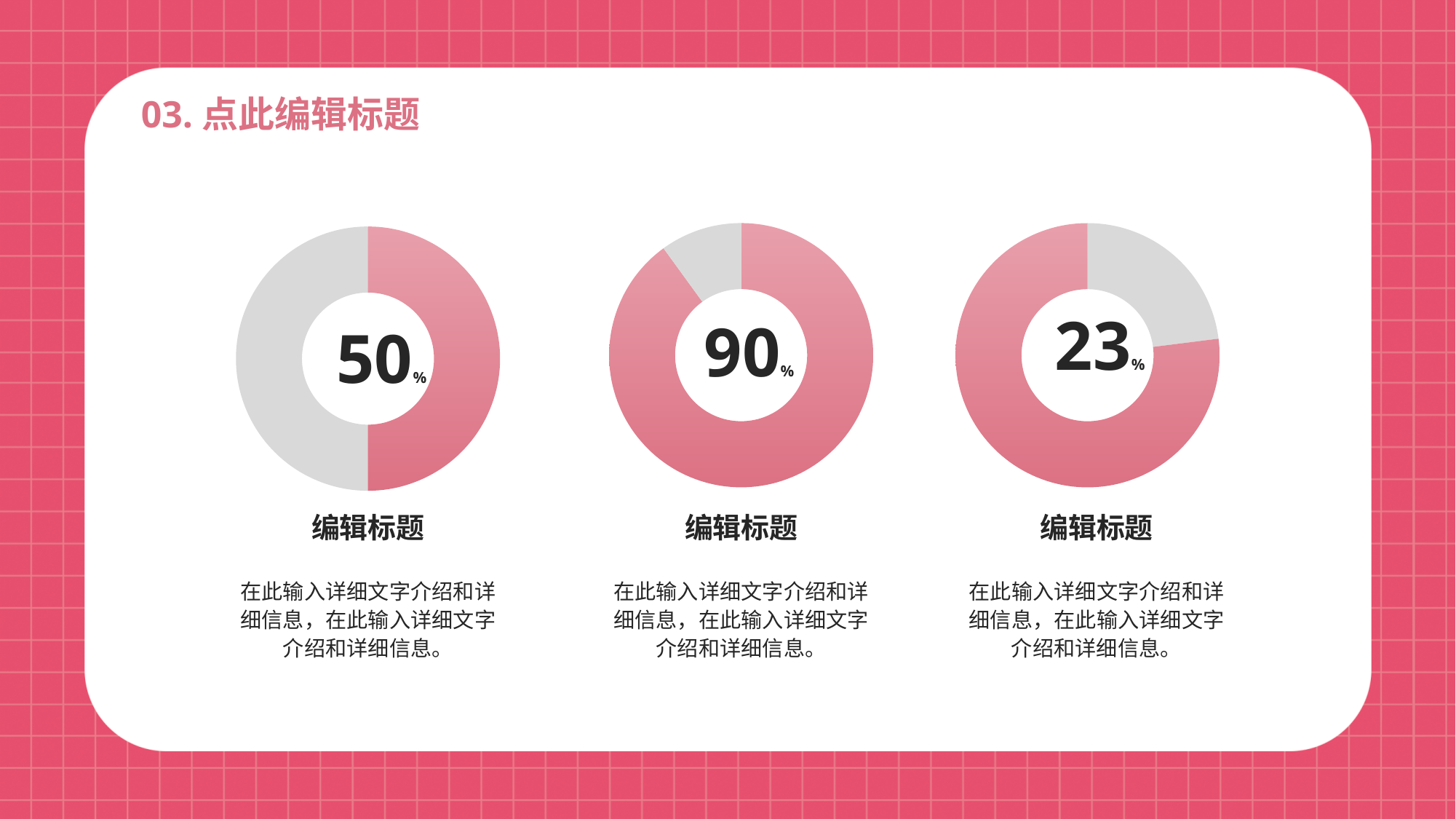
What value is shown in the centre of the left donut chart? 50% How many donut charts are on the slide? 3 What is the difference between the percentage in the middle donut chart and the percentage in the left donut chart? 40% What value is shown in the centre of the middle donut chart? 90% What kind of chart is used to display the three percentages on the slide? donut chart Which of the three donut charts shows the highest percentage? the middle one (90%) What value is shown in the centre of the right donut chart? 23% In the left donut chart, what share of the ring is filled in pink? 50% What colour is used for the filled portion of each donut chart? pink Which of the three donut charts shows the lowest percentage? the right one (23%) Is the percentage in the left donut chart larger or smaller than the percentage in the right donut chart? larger What is the difference between the percentage in the middle donut chart and the percentage in the right donut chart? 67%